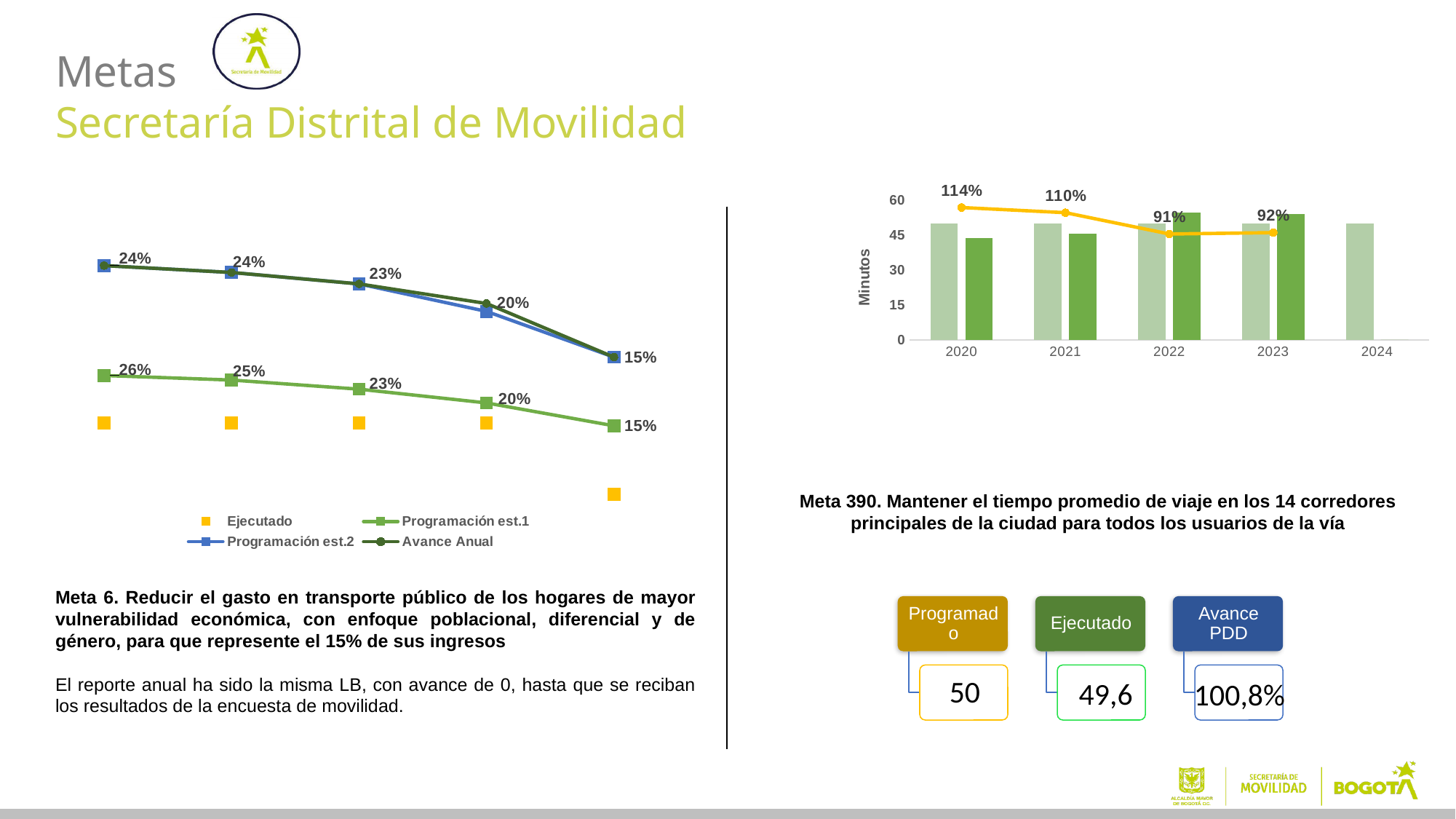
On the right chart (Meta 390), which year has the lowest percentage label on the line? 2022 On the right chart (Meta 390), which dark green bar is taller, 2020 or 2022? 2022 On the left chart (Meta 6), how many series does the legend list? 4 On the right chart (Meta 390), what is the title of the vertical axis? Minutos On the right chart (Meta 390), is the dark green bar for 2022 greater or less than 45 minutes? greater On the left chart (Meta 6), what is the value of the first point of the Programación est.1 series? 26% On the right chart (Meta 390), which year has the highest percentage label on the line? 2020 On the right chart (Meta 390), what is the difference between the percentage labels for 2020 and 2021? 4 percentage points On the left chart (Meta 6), do the values of the Programación est.1 series rise or fall from left to right? fall On the right chart (Meta 390), what is the percentage label shown for 2022? 91% On the right chart (Meta 390), how many years are shown on the x axis? 5 On the right chart (Meta 390), what is the percentage label shown above 2020? 114%